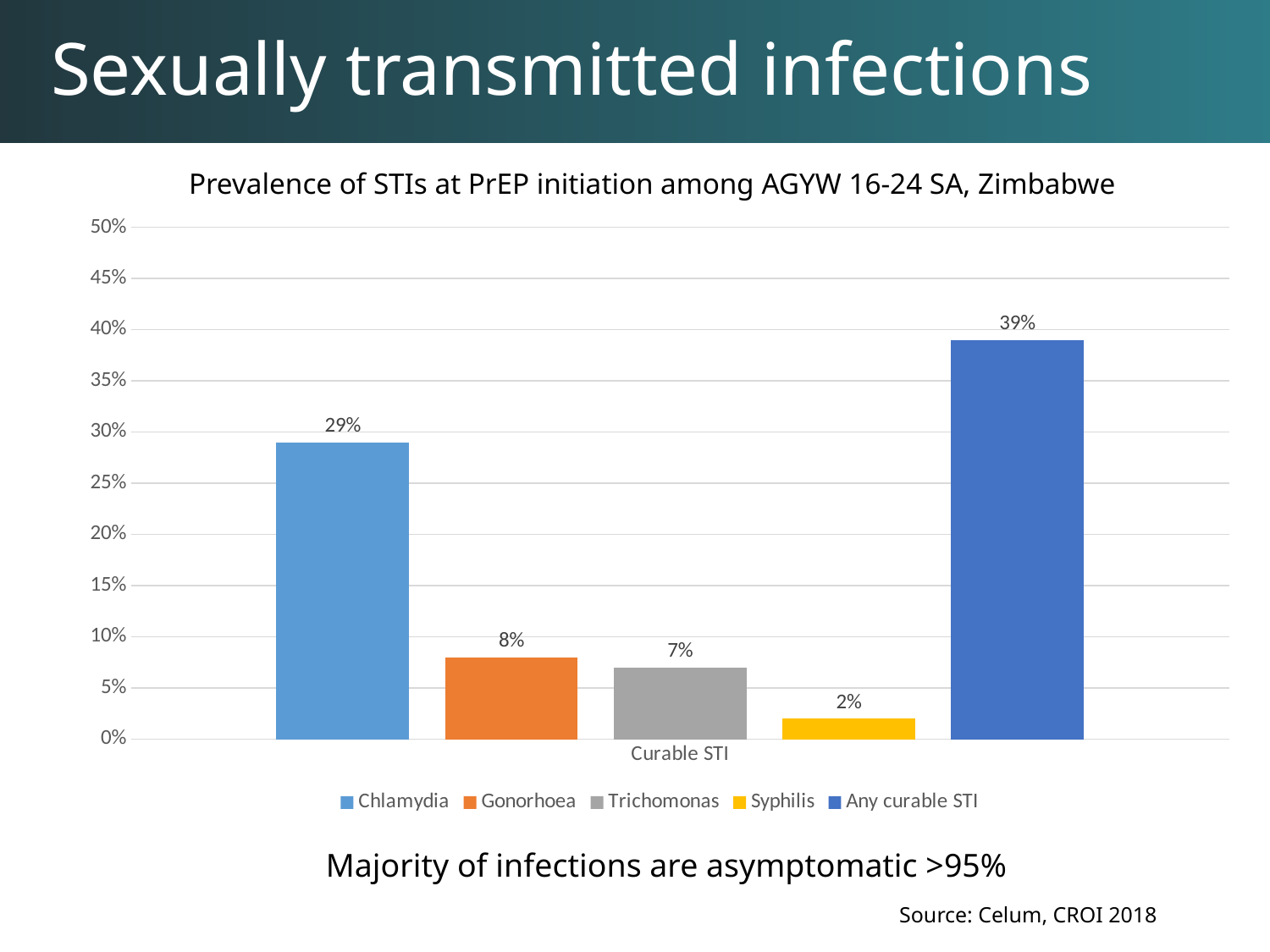
How many series does the legend list? 5 What is the difference between the Any curable STI value and the Chlamydia value? 10% Which series has the lowest value in the chart? Syphilis What is the title of the chart? Prevalence of STIs at PrEP initiation among AGYW 16-24 SA, Zimbabwe Which series has the highest value in the chart? Any curable STI What is the prevalence of Chlamydia shown in the chart? 29% What kind of chart is shown on the slide? Bar chart What is the difference between the Gonorhoea value and the Trichomonas value? 1% What is the prevalence of Gonorhoea shown in the chart? 8% What is the value for Any curable STI? 39% What is the prevalence of Syphilis shown in the chart? 2% Which is larger, the value for Chlamydia or the value for Gonorhoea? Chlamydia